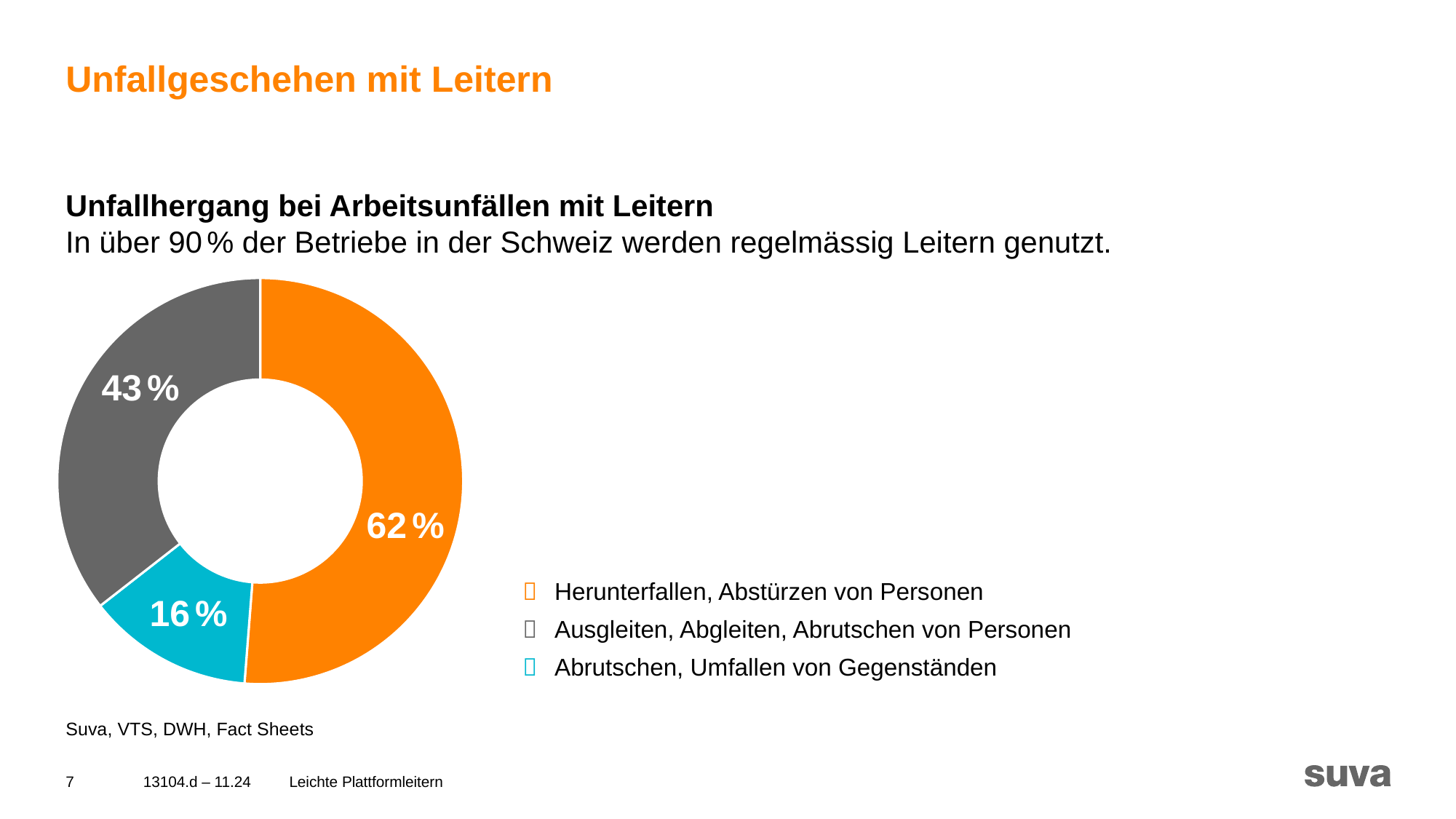
What kind of chart is shown on the slide? Pie chart (donut) What percentage is shown for "Herunterfallen, Abstürzen von Personen"? 62 % What is the difference in percentage points between "Herunterfallen, Abstürzen von Personen" and "Ausgleiten, Abgleiten, Abrutschen von Personen"? 19 percentage points What colour is the slice for "Abrutschen, Umfallen von Gegenständen"? Cyan (light blue) What percentage is shown for "Abrutschen, Umfallen von Gegenständen"? 16 % Which is larger: the slice for "Ausgleiten, Abgleiten, Abrutschen von Personen" or the slice for "Abrutschen, Umfallen von Gegenständen"? Ausgleiten, Abgleiten, Abrutschen von Personen Which category has the smallest slice in the chart? Abrutschen, Umfallen von Gegenständen Which category has the largest slice in the chart? Herunterfallen, Abstürzen von Personen What is the difference in percentage points between "Ausgleiten, Abgleiten, Abrutschen von Personen" and "Abrutschen, Umfallen von Gegenständen"? 27 percentage points What is the heading above the chart? Unfallhergang bei Arbeitsunfällen mit Leitern How many slices does the chart have? 3 What percentage is shown for "Ausgleiten, Abgleiten, Abrutschen von Personen"? 43 %